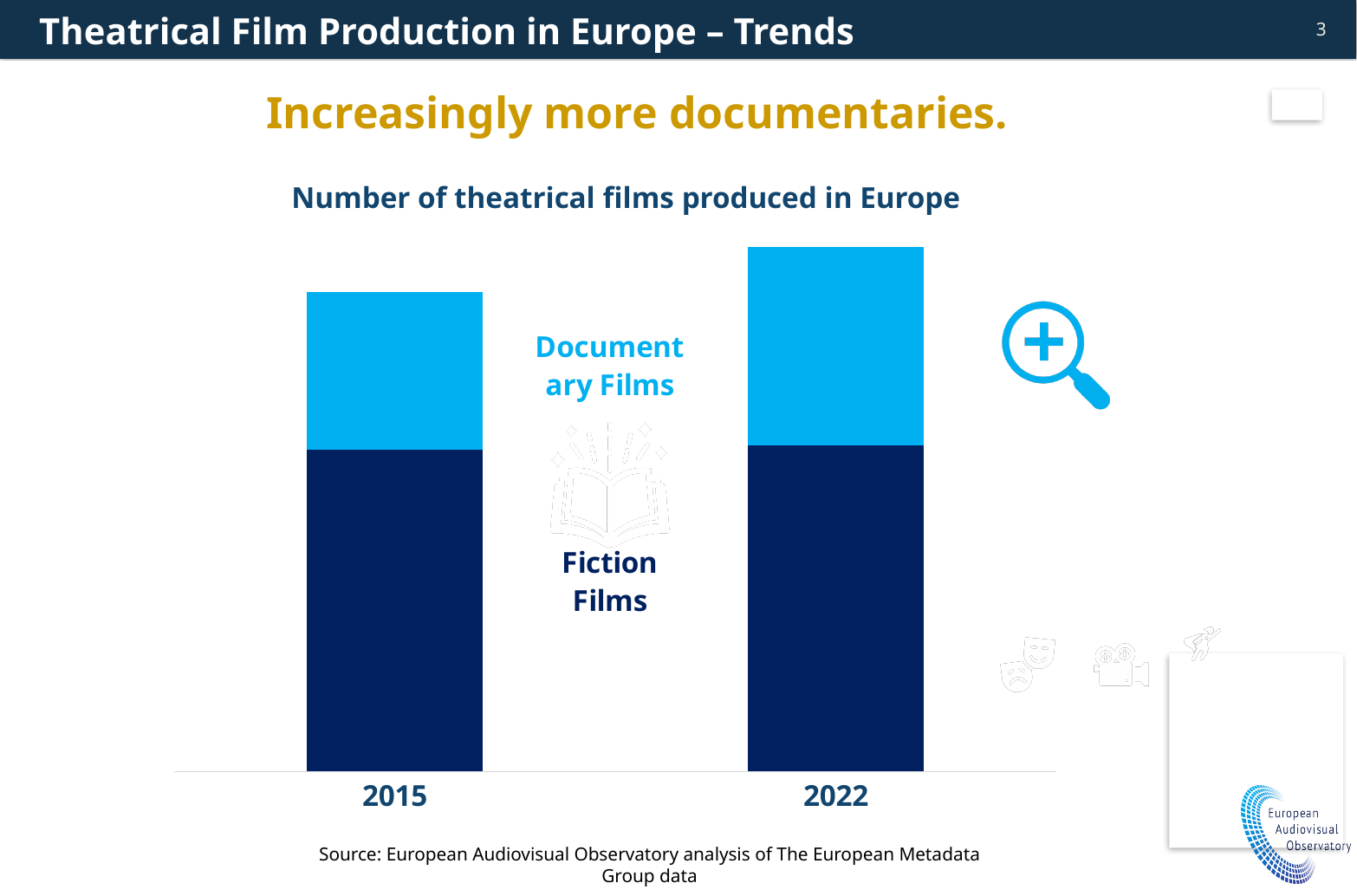
How many years are shown on the x axis of the chart? 2 Which year has the largest total bar? 2022 Which year has the taller total bar, 2015 or 2022? 2022 What is the title of the chart? Number of theatrical films produced in Europe Which year has the smaller total bar? 2015 Which two series are shown in the chart? Documentary Films and Fiction Films Does the total number of theatrical films produced rise or fall from 2015 to 2022? Rise What kind of chart is shown on the slide? Stacked bar chart How many series does the chart show? 2 Is the Documentary Films segment larger in 2015 or in 2022? 2022 In 2022, which segment is larger: Fiction Films or Documentary Films? Fiction Films